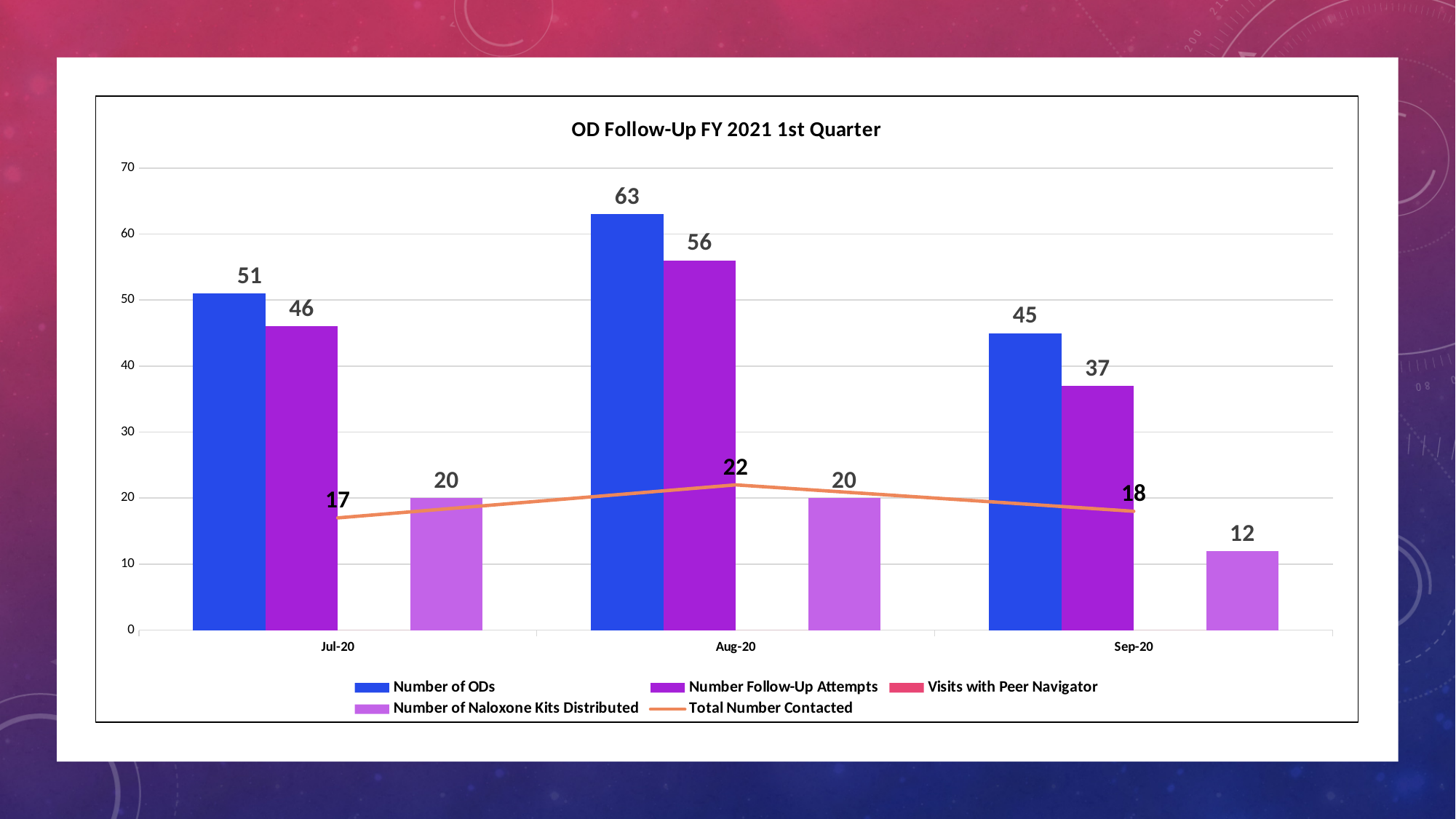
What is the Number of Naloxone Kits Distributed in Sep-20? 12 Which month has the lowest Number of Naloxone Kits Distributed? Sep-20 What is the title of the chart? OD Follow-Up FY 2021 1st Quarter What is the Number of ODs for Aug-20? 63 Does the Number Follow-Up Attempts rise or fall from Aug-20 to Sep-20? fall What is the difference between the Number of ODs and the Number Follow-Up Attempts in Jul-20? 5 How many months are shown on the x axis? 3 What is the Total Number Contacted for Jul-20? 17 Which is larger in Sep-20: the Number of ODs or the Number Follow-Up Attempts? Number of ODs What is the Number Follow-Up Attempts value for Sep-20? 37 Which month has the highest Number of ODs? Aug-20 How many series does the legend list? 5